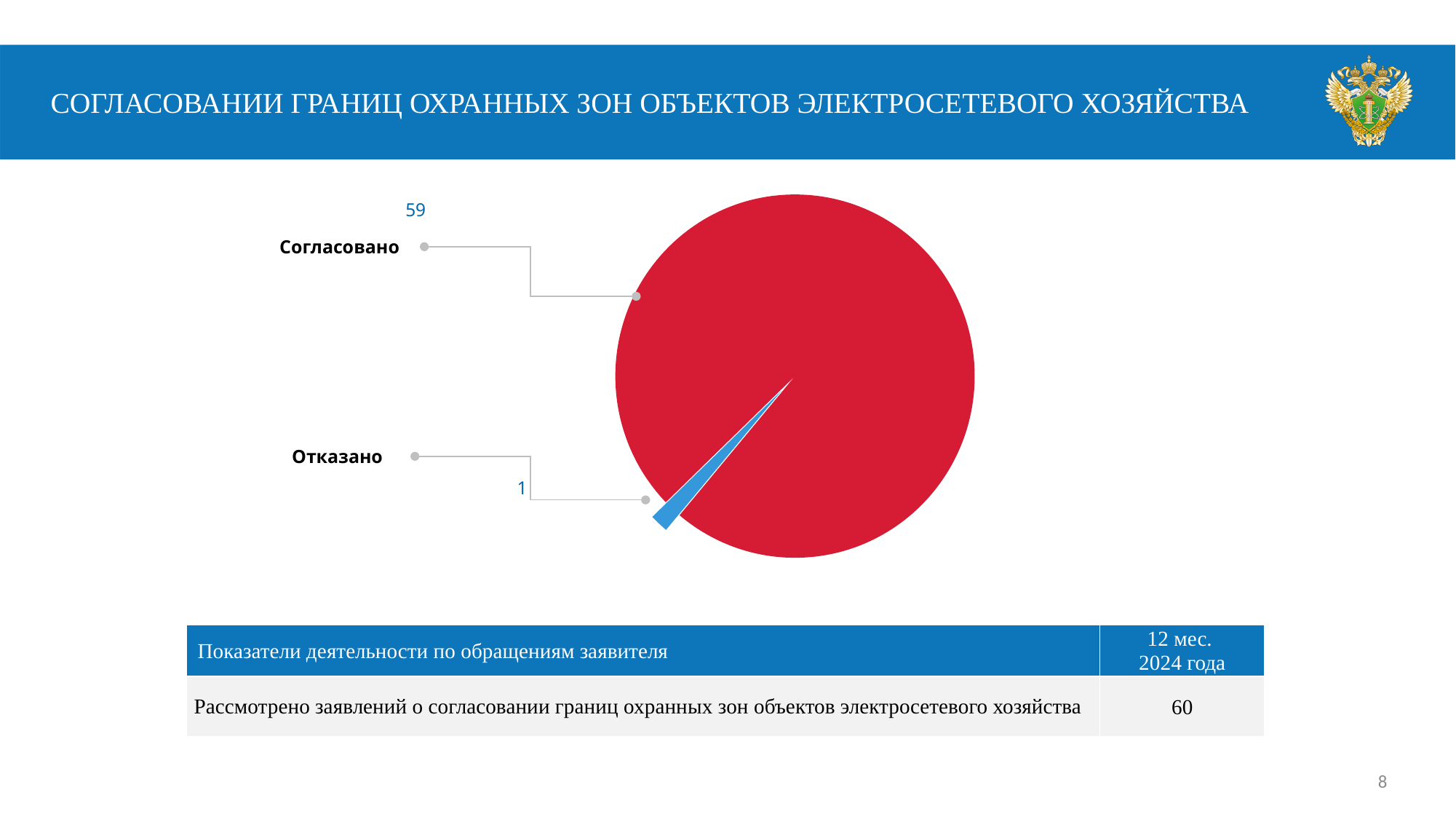
What is the value for Согласовано in the pie chart? 59 What is the value for Отказано in the pie chart? 1 What colour is the Отказано slice in the pie chart? Blue Which category has the largest slice in the pie chart? Согласовано Which is larger, the value for Согласовано or the value for Отказано? Согласовано What fraction of the pie total does the Отказано slice represent? 1 out of 60 How many categories are shown in the pie chart? 2 Which category has the smallest slice in the pie chart? Отказано What is the total of the two values shown in the pie chart? 60 What is the difference between the values for Согласовано and Отказано? 58 What colour is the Согласовано slice in the pie chart? Red What kind of chart is shown on the slide? Pie chart